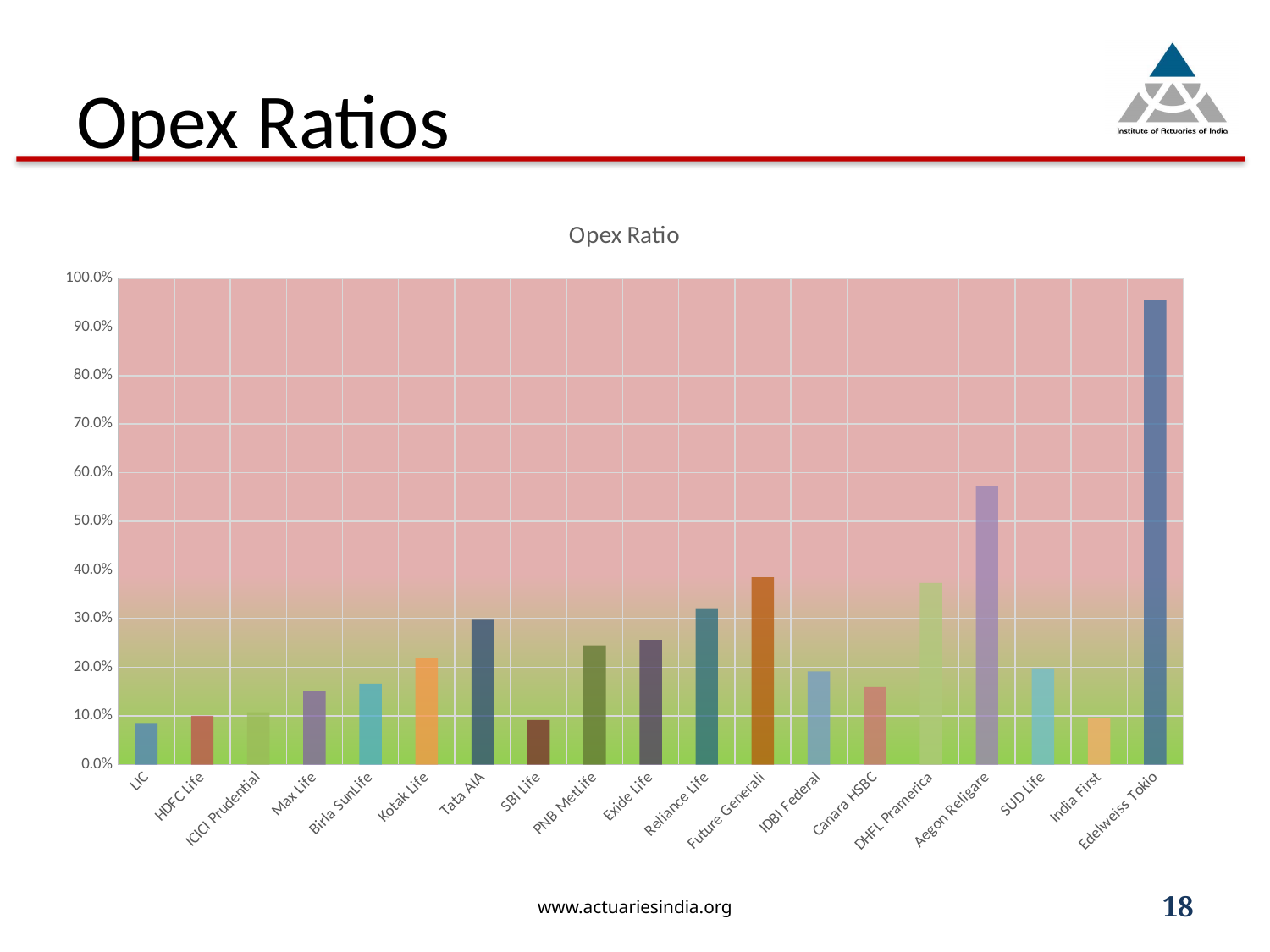
Is the value for Future Generali greater or less than 40.0%? less Is the value for Edelweiss Tokio greater or less than 90.0%? greater Which company has the highest opex ratio? Edelweiss Tokio Is the value for Canara HSBC greater or less than 20.0%? less Which has a higher opex ratio, Kotak Life or Birla SunLife? Kotak Life Which has a higher opex ratio, Future Generali or Reliance Life? Future Generali How many companies are shown on the x axis of the chart? 19 What kind of chart is shown on the slide? bar chart What is the title of the chart? Opex Ratio Which has a higher opex ratio, Aegon Religare or DHFL Pramerica? Aegon Religare